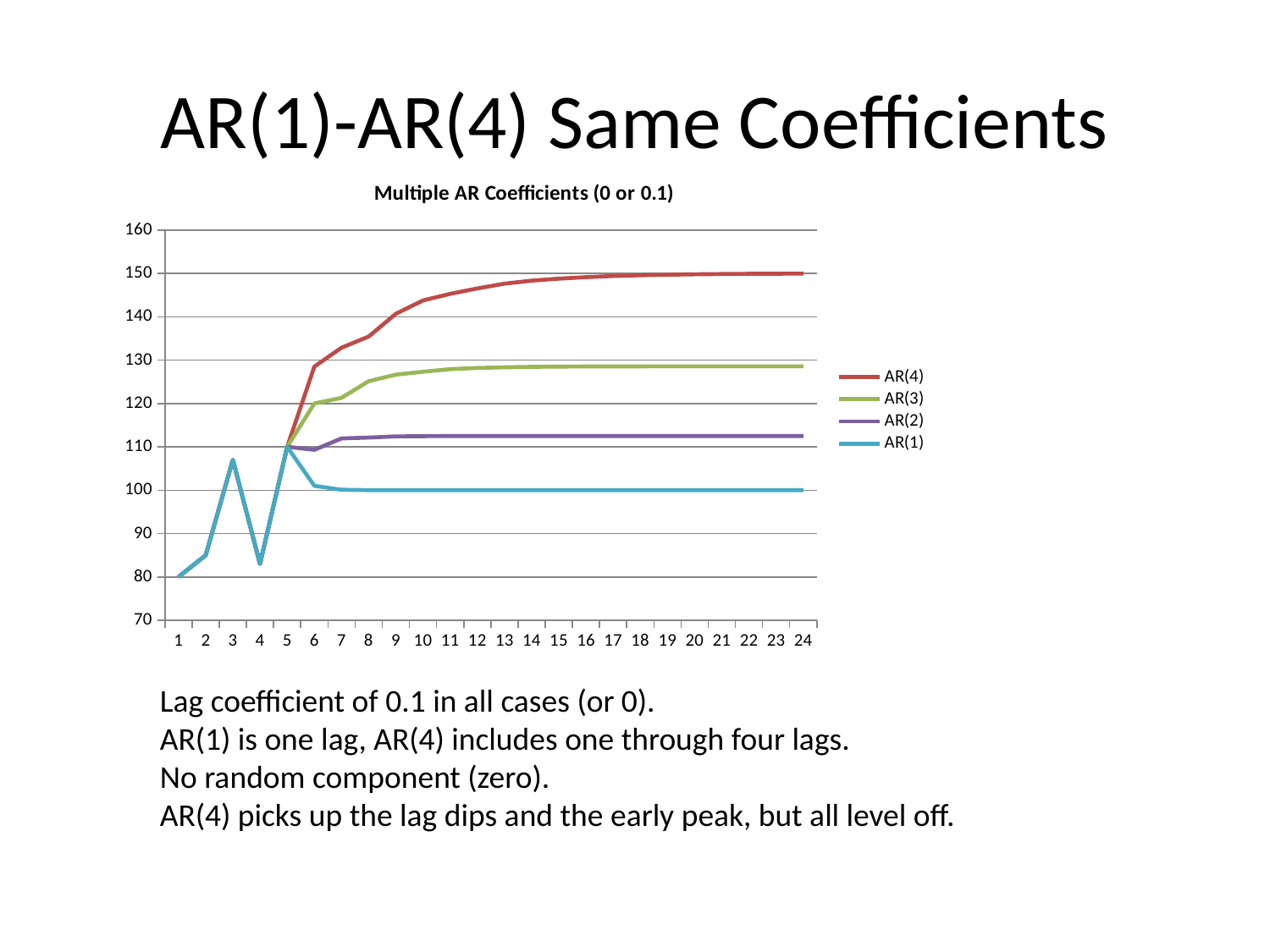
How many points are on the x axis of the chart? 24 Which series has the lowest value at x = 24? AR(1) What kind of chart is shown on the slide? Line chart Does the AR(4) series rise or fall from x = 6 to x = 24? rise Which series has the larger value at x = 12, AR(3) or AR(2)? AR(3) Is the value for AR(2) at x = 24 greater or less than 120? less Is the value for AR(3) at x = 24 greater or less than 120? greater Is the value for AR(4) at x = 10 greater or less than 140? greater What colour is the AR(4) line in the legend? Red What is the title of the chart? Multiple AR Coefficients (0 or 0.1) Which series has the highest value at x = 24? AR(4) How many series does the legend list? 4